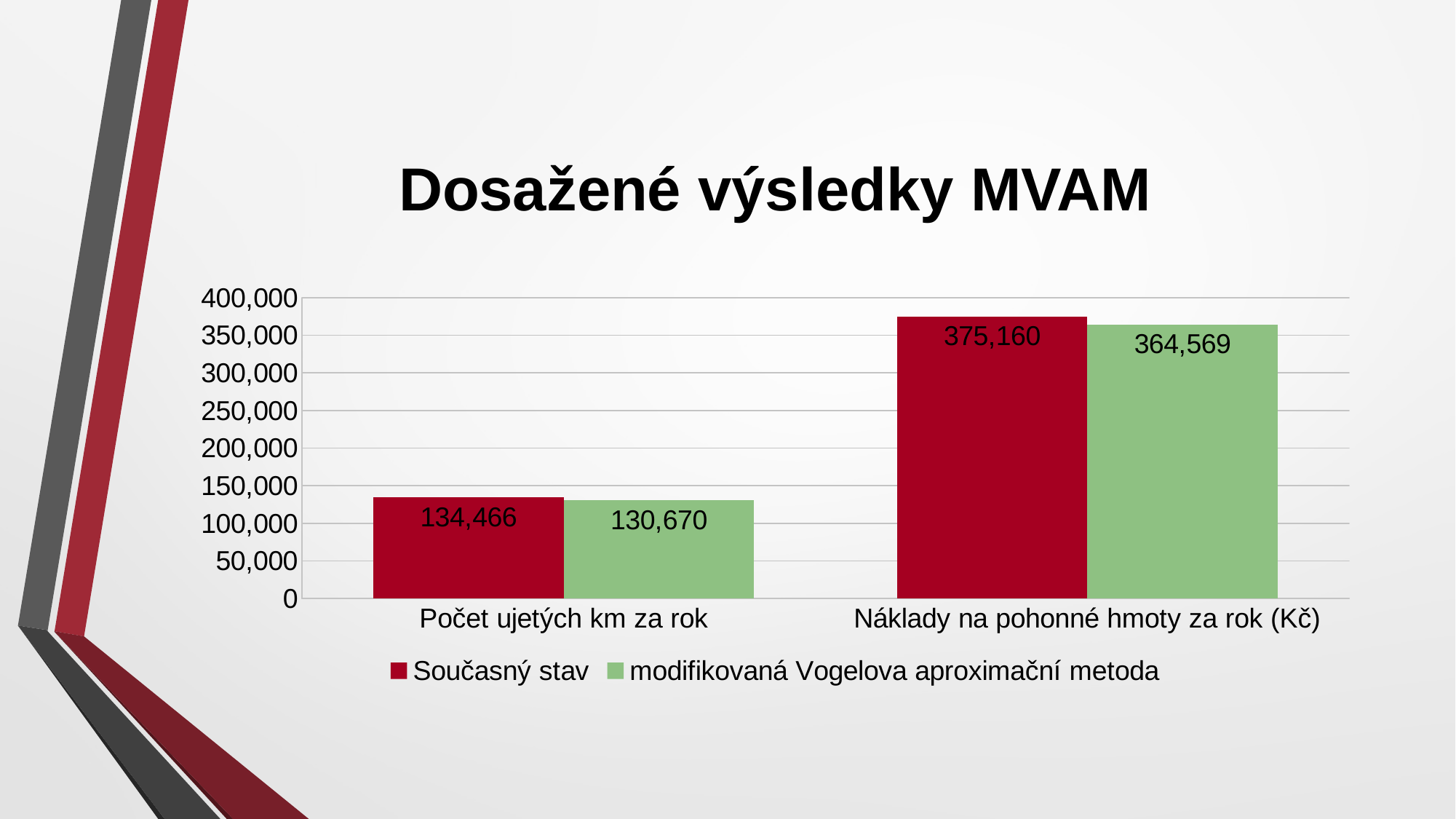
Is the value for modifikovaná Vogelova aproximační metoda in Počet ujetých km za rok greater or less than 150,000? less How many categories are shown on the x axis? 2 What is the value for Současný stav in the category Náklady na pohonné hmoty za rok (Kč)? 375,160 How many series does the legend list? 2 What is the value for modifikovaná Vogelova aproximační metoda in the category Počet ujetých km za rok? 130,670 What is the difference between the Současný stav and modifikovaná Vogelova aproximační metoda values for Počet ujetých km za rok? 3,796 In the category Náklady na pohonné hmoty za rok (Kč), which series has the larger value, Současný stav or modifikovaná Vogelova aproximační metoda? Současný stav What is the value for modifikovaná Vogelova aproximační metoda in the category Náklady na pohonné hmoty za rok (Kč)? 364,569 What is the value for Současný stav in the category Počet ujetých km za rok? 134,466 Which category has the highest value for Současný stav? Náklady na pohonné hmoty za rok (Kč) What type of chart is shown on the slide? bar chart What is the difference between the Současný stav and modifikovaná Vogelova aproximační metoda values for Náklady na pohonné hmoty za rok (Kč)? 10,591